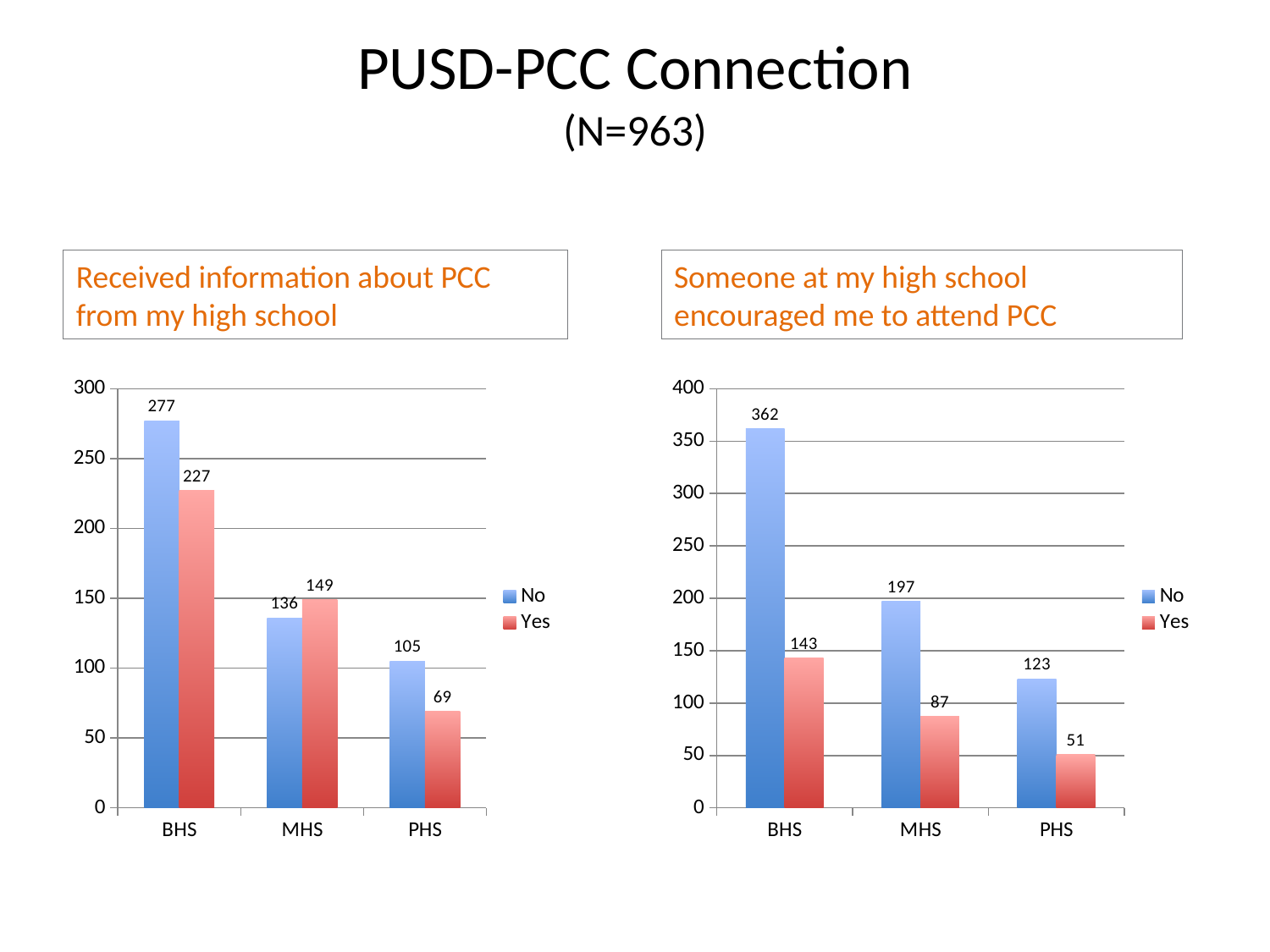
In the 'Received information about PCC from my high school' chart, what is the value for No at BHS? 277 How many schools are shown on the x axis of the 'Received information about PCC from my high school' chart? 3 How many series does the legend list in the 'Someone at my high school encouraged me to attend PCC' chart? 2 In the 'Received information about PCC from my high school' chart, which school has the lowest Yes value? PHS In the 'Received information about PCC from my high school' chart, which is larger at MHS, No or Yes? Yes In the 'Someone at my high school encouraged me to attend PCC' chart, what is the value for Yes at PHS? 51 In the 'Received information about PCC from my high school' chart, what is the value for Yes at MHS? 149 In the 'Someone at my high school encouraged me to attend PCC' chart, which school has the highest No value? BHS In the 'Someone at my high school encouraged me to attend PCC' chart, what is the value for No at BHS? 362 In the 'Someone at my high school encouraged me to attend PCC' chart, what is the difference between No and Yes at MHS? 110 What kind of chart is the 'Someone at my high school encouraged me to attend PCC' chart? Bar chart In the 'Received information about PCC from my high school' chart, what is the difference between No and Yes at BHS? 50